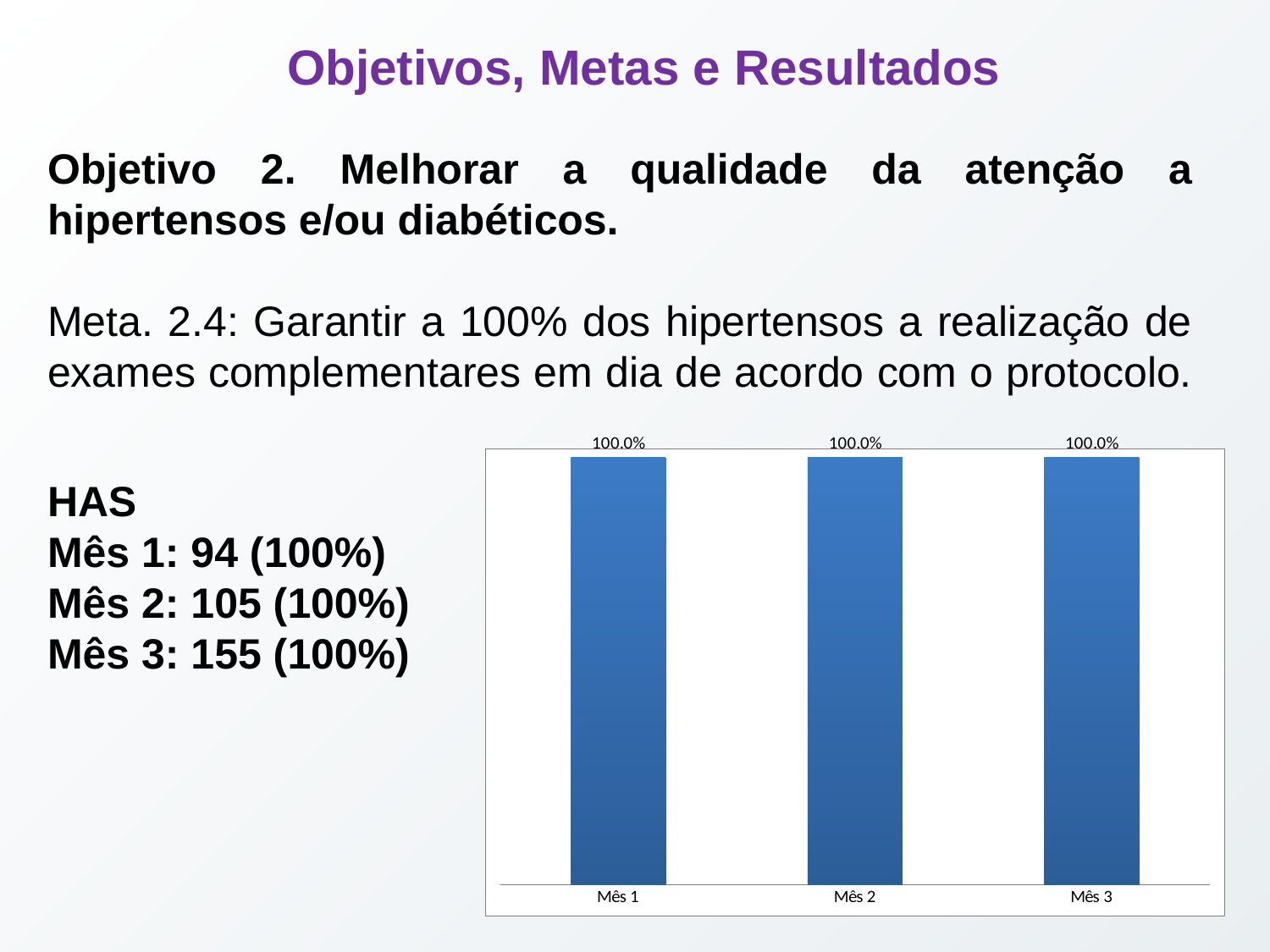
What kind of chart is shown on the slide? bar chart What is the value shown for Mês 2 in the bar chart? 100.0% What are the category labels on the x axis of the chart? Mês 1, Mês 2, Mês 3 How many categories are plotted in the bar chart? 3 Do the values in the chart rise, fall, or stay the same from Mês 1 to Mês 3? stay the same What is the value shown for Mês 1 in the bar chart? 100.0% What colour are the bars in the chart? blue What is the difference between the values for Mês 2 and Mês 1 in the chart? 0.0% What is the value shown for Mês 3 in the bar chart? 100.0% What is the difference between the values for Mês 3 and Mês 1 in the chart? 0.0%